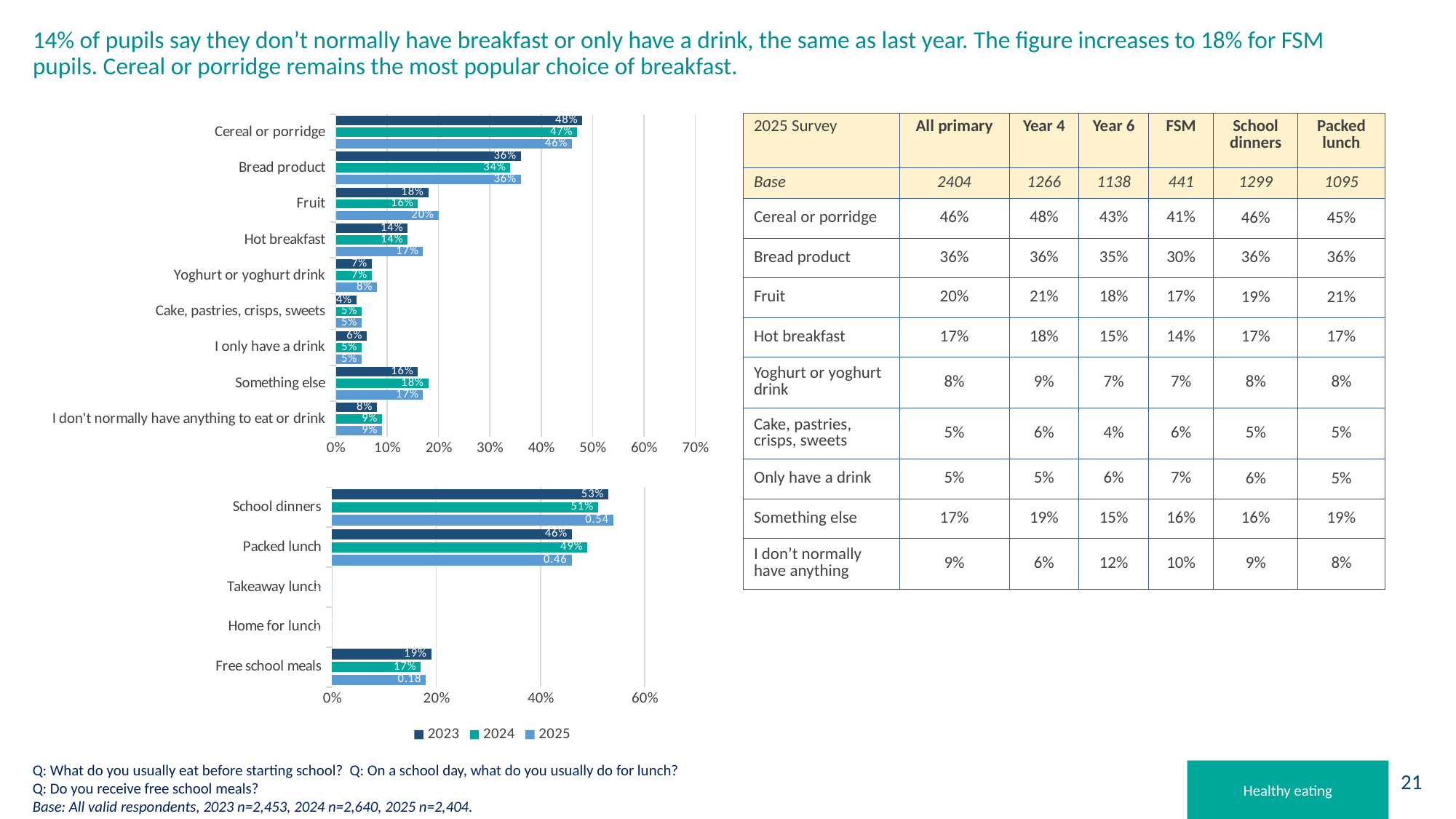
In the bottom chart (lunch), what is the 2024 value for Packed lunch? 49% In the top chart (breakfast), what is the difference between the 2025 and 2023 values for Hot breakfast? 3% How many series does the legend list? 3 In the top chart (breakfast), what is the 2023 value for Bread product? 36% In the top chart (breakfast), which is larger for Something else: the 2023 value or the 2024 value? 2024 In the top chart (breakfast), which category has the highest 2025 value? Cereal or porridge In the top chart (breakfast), what is the 2025 value for Cereal or porridge? 46% In the top chart (breakfast), what is the 2024 value for Fruit? 16% In the bottom chart (lunch), what is the 2023 value for Free school meals? 19% In the bottom chart (lunch), what is the 2025 value for School dinners as labelled? 0.54 In the top chart (breakfast), how many categories are shown on the y axis? 9 What type of chart is the bottom chart (lunch)? Bar chart